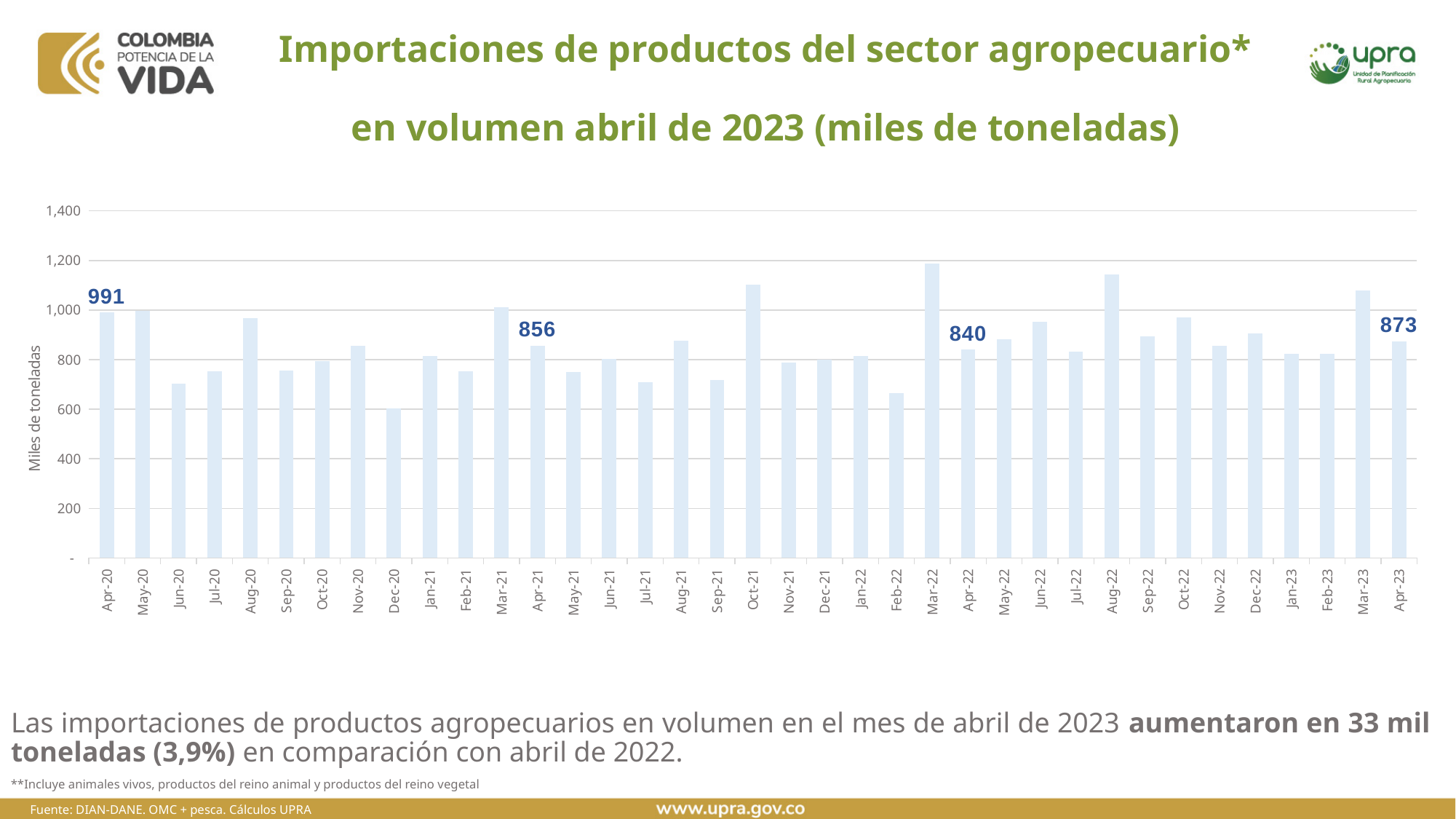
How many monthly bars are plotted in the chart? 37 Is the value for Dec-20 greater or less than 800? less Which is larger, the value for Apr-20 or the value for Apr-23? Apr-20 What is the value for Apr-22? 840 Which month has the highest bar? Mar-22 Which month has the lowest bar? Dec-20 Is the value for Mar-22 greater or less than 1,000? greater What is the difference between the values for Apr-23 and Apr-22? 33 What is the value for Apr-20? 991 What kind of chart is shown on the slide? Bar chart What is the value for Apr-21? 856 What is the value for Apr-23? 873